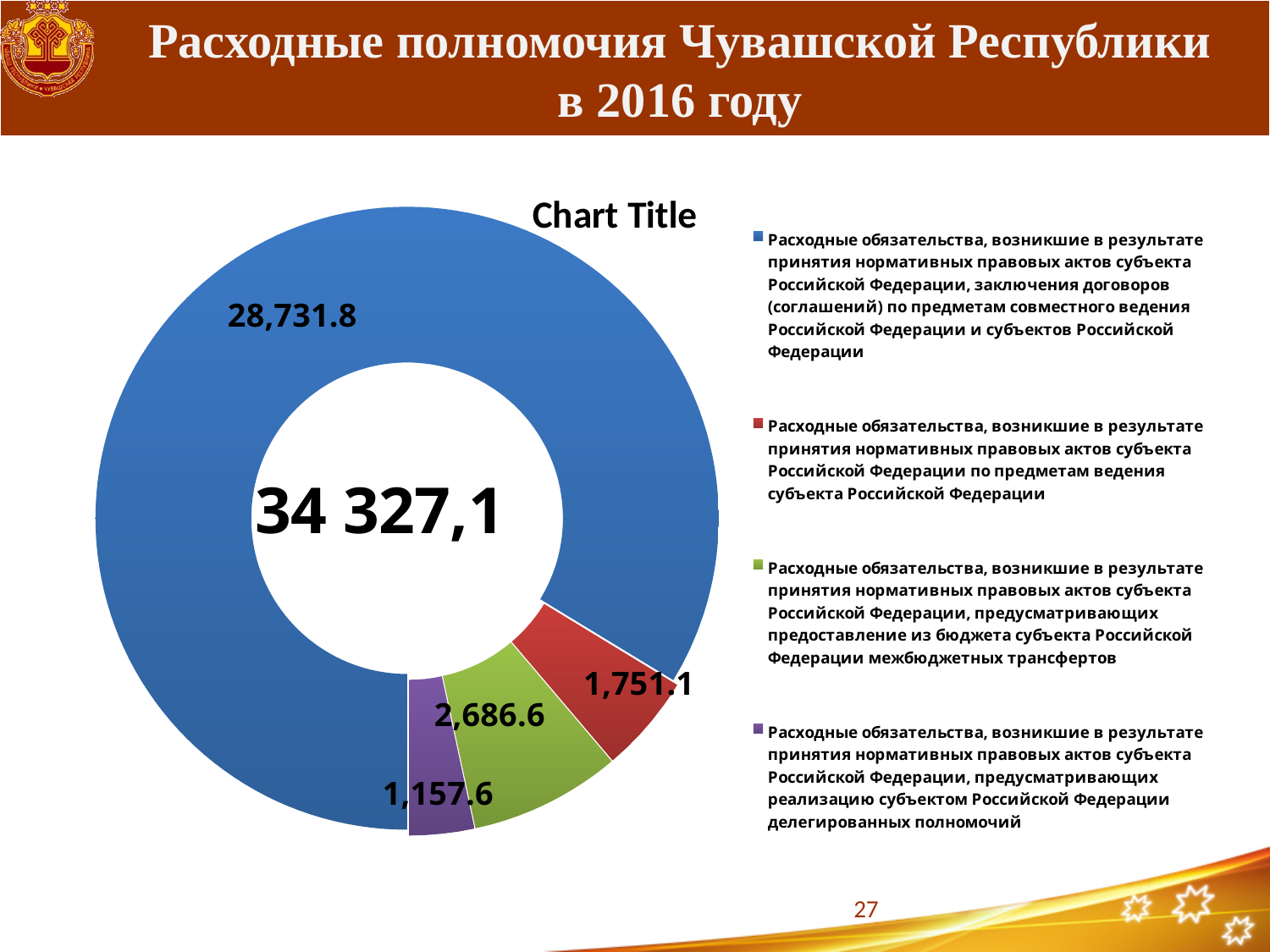
Which slice of the doughnut chart has the largest value? 28,731.8 (blue, joint jurisdiction) What value is shown for the red slice, which corresponds to the legend entry about expenditure obligations on subjects under the jurisdiction of the subject of the Russian Federation (по предметам ведения субъекта)? 1,751.1 What number is printed in the centre of the doughnut chart? 34 327,1 What value is shown for the purple slice, which corresponds to the legend entry about delegated powers (делегированных полномочий)? 1,157.6 What is the difference between the red slice (1,751.1) and the purple slice (1,157.6)? 593.5 What kind of chart is shown on the slide? Doughnut (pie) chart What is the difference between the green slice (2,686.6) and the red slice (1,751.1)? 935.5 What is the value of the largest (blue) slice of the doughnut chart? 28,731.8 What value is shown for the green slice, which corresponds to the legend entry about interbudgetary transfers (межбюджетных трансфертов)? 2,686.6 Which slice of the doughnut chart has the smallest value? 1,157.6 (purple, delegated powers) How many slices does the doughnut chart have? 4 Which is larger: the green slice or the red slice? The green slice (2,686.6)